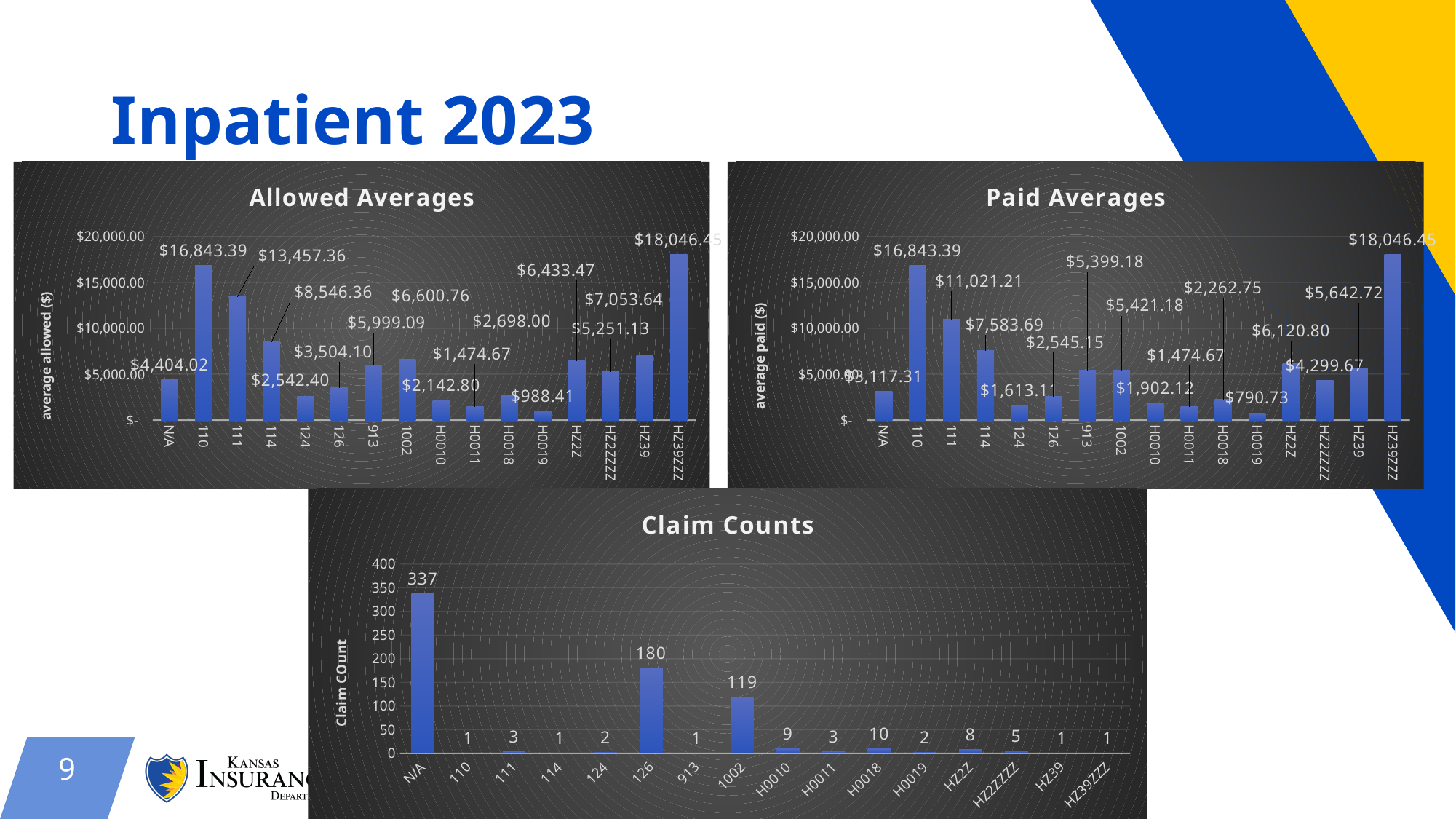
In the Claim Counts chart, what is the claim count for N/A? 337 What kind of chart is the Claim Counts chart? bar chart In the Allowed Averages chart, which category has the lowest average allowed? H0019 In the Claim Counts chart, what is the difference between the claim counts for N/A and 126? 157 In the Allowed Averages chart, what is the average allowed for 110? $16,843.39 In the Paid Averages chart, what is the average paid for HZ39ZZZ? $18,046.45 In the Paid Averages chart, which is larger, the average paid for 110 or for 111? 110 In the Paid Averages chart, what is the average paid for H0019? $790.73 In the Allowed Averages chart, which category has the highest average allowed? HZ39ZZZ How many categories are shown on the x axis of the Claim Counts chart? 16 In the Claim Counts chart, what is the claim count for 1002? 119 In the Claim Counts chart, which category has the highest claim count? N/A